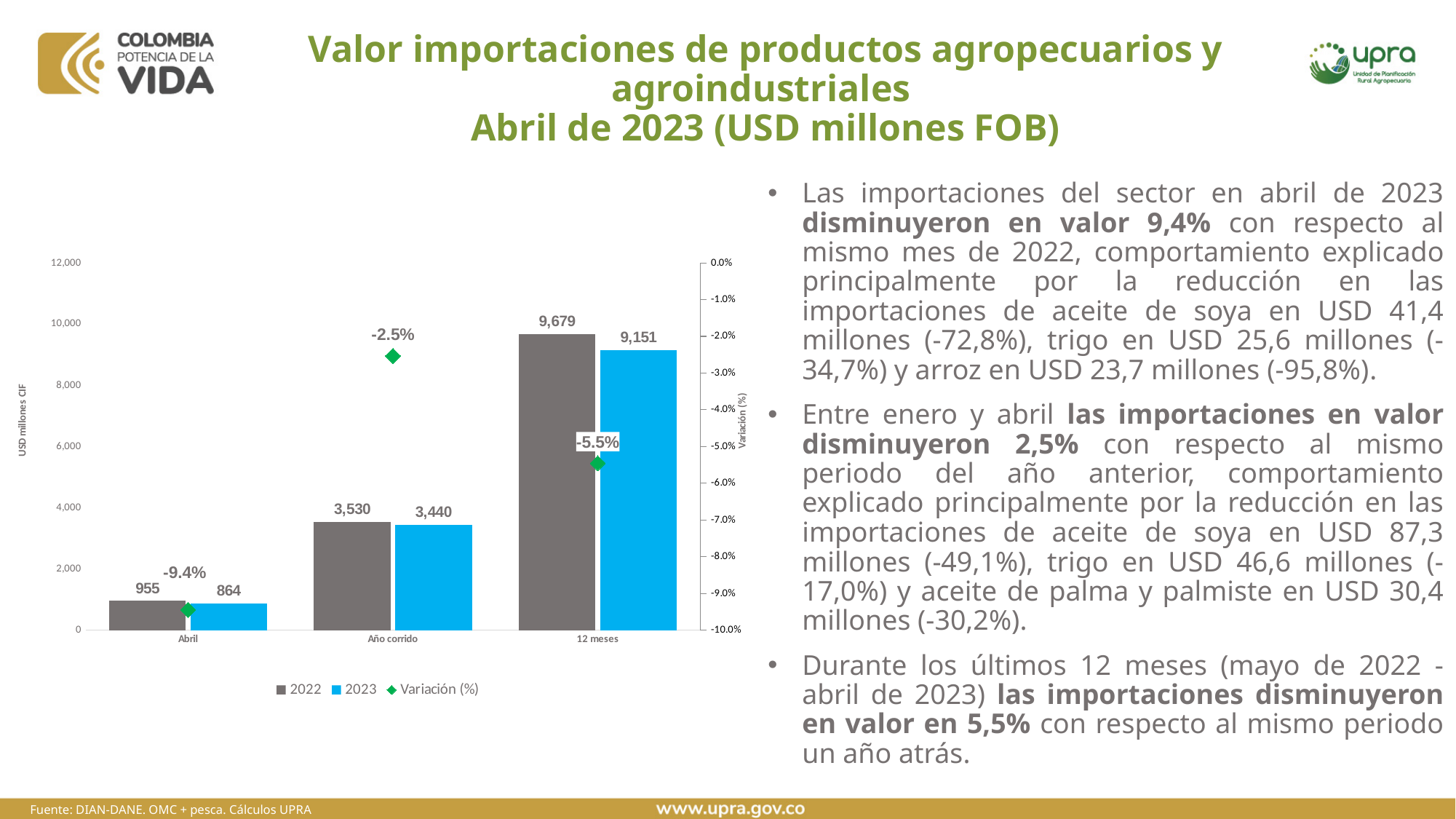
What is the difference between the 2022 and 2023 values in the 12 meses category? 528 Which category has the highest 2022 value? 12 meses How many categories are shown on the x axis? 3 Which category has the lowest 2023 value? Abril Which is larger in the Año corrido category, the 2022 value or the 2023 value? 2022 How many series does the legend list? 3 What is the value for 2022 in the Abril category? 955 What kind of chart is used for the 2022 and 2023 series? Bar chart What is the label of the left vertical axis? USD millones CIF What is the Variación (%) shown for the 12 meses category? -5.5% What is the value for 2023 in the Año corrido category? 3,440 What is the value for 2023 in the 12 meses category? 9,151